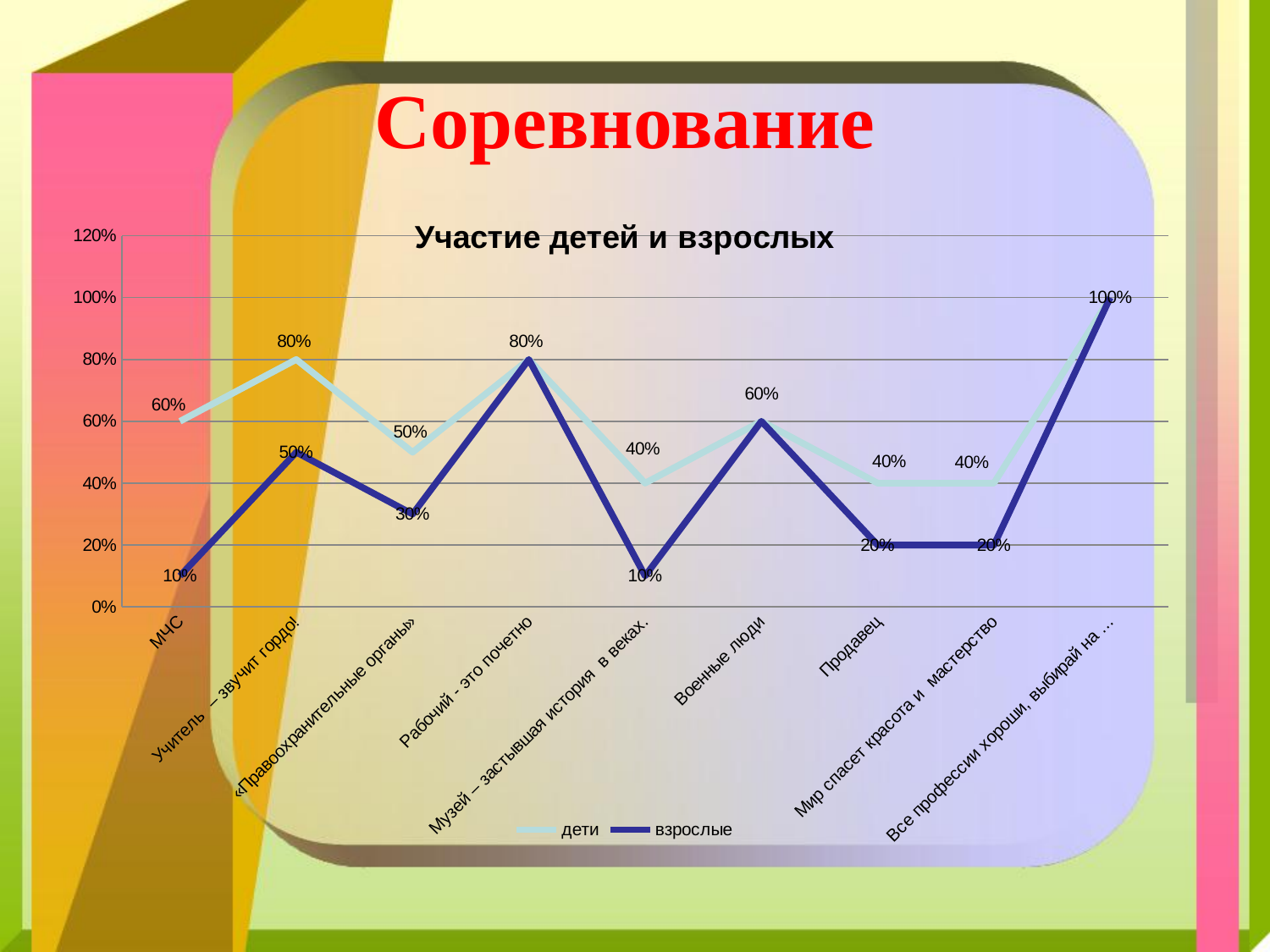
Which category has the highest value for взрослые? Все профессии хороши, выбирай на ... What is the value for взрослые at «Правоохранительные органы»? 30% What kind of chart is shown on the slide? line chart Which is larger at Музей – застывшая история в веках: дети or взрослые? дети Which series is drawn in dark blue? взрослые How many categories are shown on the x axis? 9 What is the value for дети at Продавец? 40% What is the value for дети at МЧС? 60% How many series does the legend list? 2 What is the value for взрослые at МЧС? 10% What is the title of the chart? Участие детей и взрослых What is the difference between дети and взрослые at Учитель – звучит гордо!? 30%